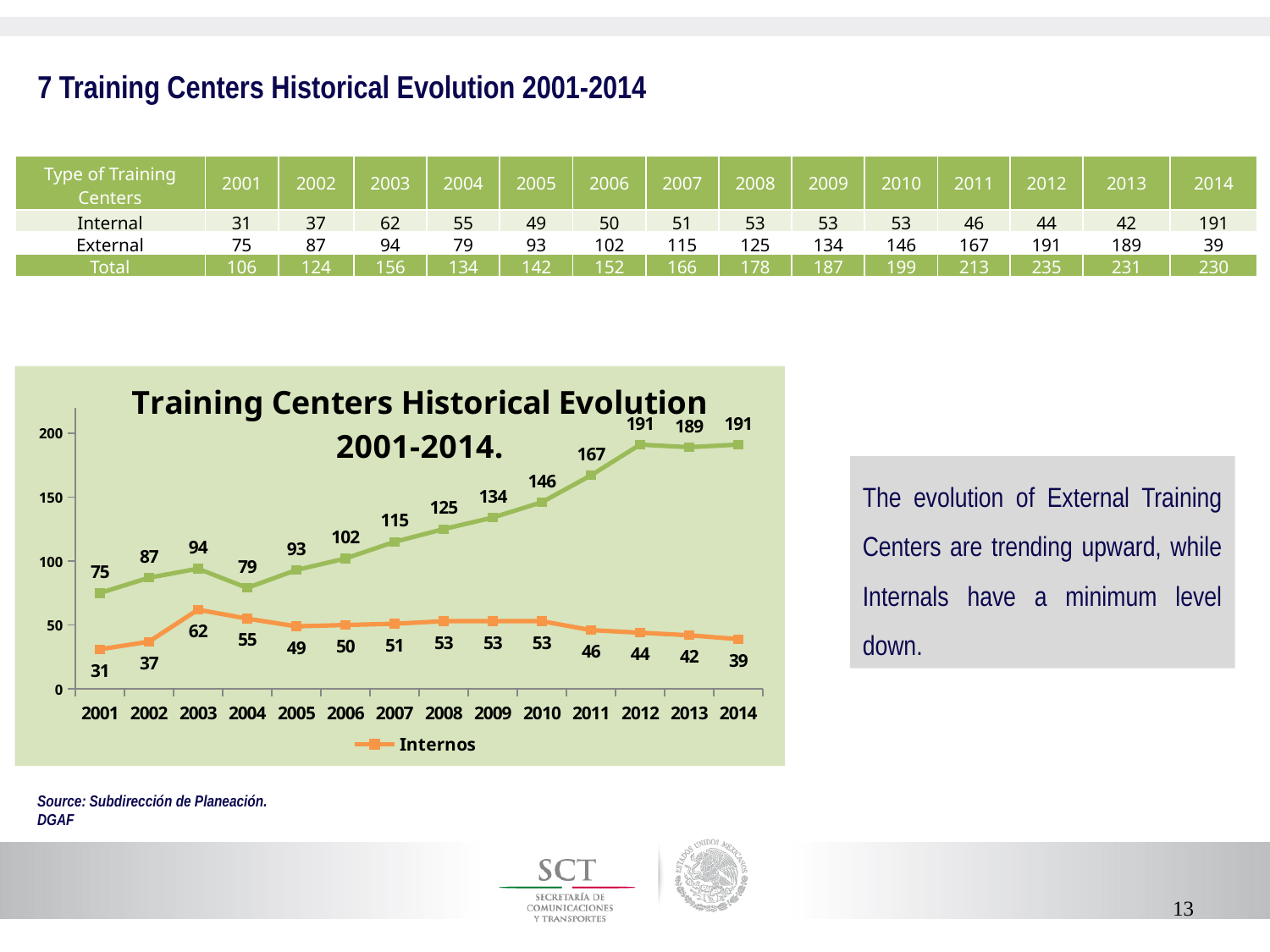
In which year is the green line at its lowest value? 2001 In 2014, which is larger: the green line's value or the Internos value? the green line What is the value of the Internos series in 2003? 62 How many years are shown on the x axis of the chart? 14 What kind of chart is shown on the slide? line chart What is the value of the green line in 2001? 75 In which year does the Internos series have its lowest value? 2001 What is the value of the green line in 2011? 167 What is the difference between the green line's value in 2014 and its value in 2001? 116 What is the value of the Internos series in 2014? 39 In which year does the Internos series reach its highest value? 2003 By how much did the Internos value increase from 2001 to 2003? 31